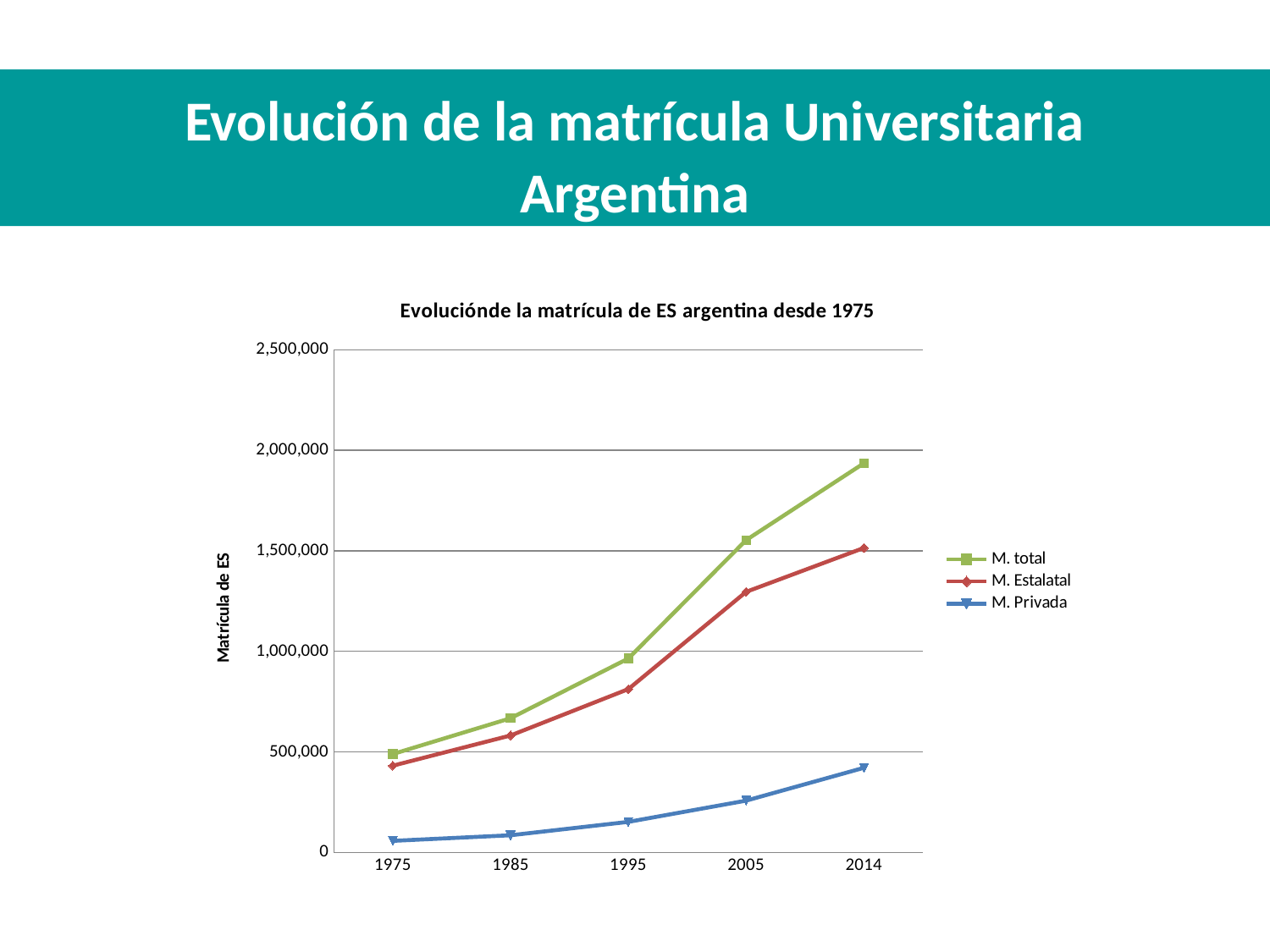
Which series has the lowest value in 1975? M. Privada Do the values for M. Privada rise or fall from 1975 to 2014? rise Is the value for M. total in 2014 greater or less than 2,000,000? less In 2005, which is larger: M. Estalatal or M. Privada? M. Estalatal Which series has the highest value in 2014? M. total Is the value for M. Privada in 2014 greater or less than 500,000? less Is the value for M. total in 1995 greater or less than 1,000,000? less What kind of chart is shown on the slide? line chart How many years are plotted along the x axis? 5 What is the label on the vertical axis of the chart? Matrícula de ES How many series does the legend list? 3